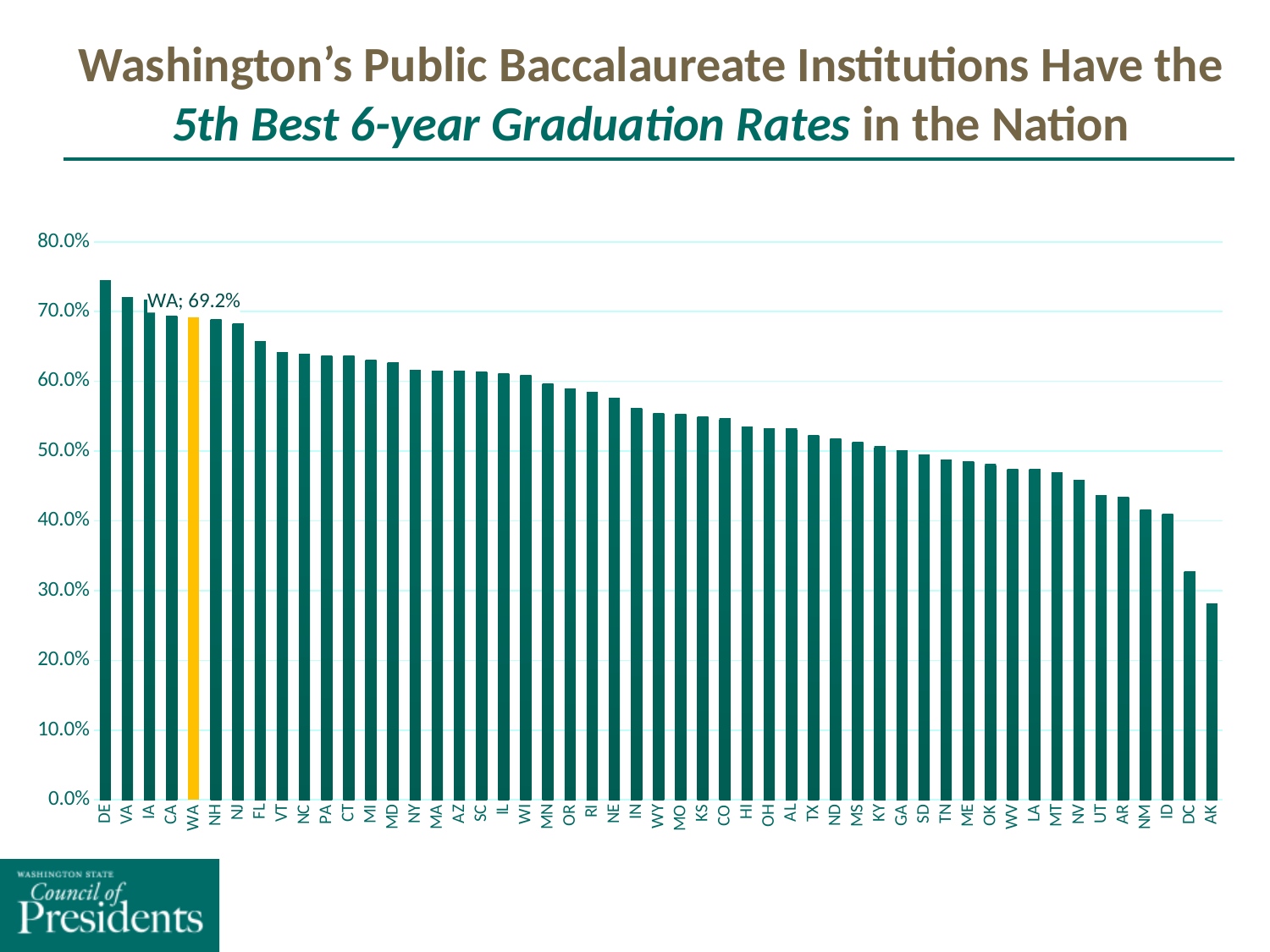
Which bar is highlighted in a different colour (yellow) from the rest? WA Which state has the lowest 6-year graduation rate in the chart? AK What is the 6-year graduation rate shown for WA? 69.2% Is the value for DE greater or less than 70.0%? greater Which state has the highest 6-year graduation rate in the chart? DE Is the value for AK greater or less than 30.0%? less Which has a higher 6-year graduation rate, DE or AK? DE What kind of chart is shown on the slide? Bar chart Is the value for FL greater or less than 60.0%? greater How many states/jurisdictions are plotted in the chart? 51 Do the values rise or fall moving from left to right along the x axis? Fall